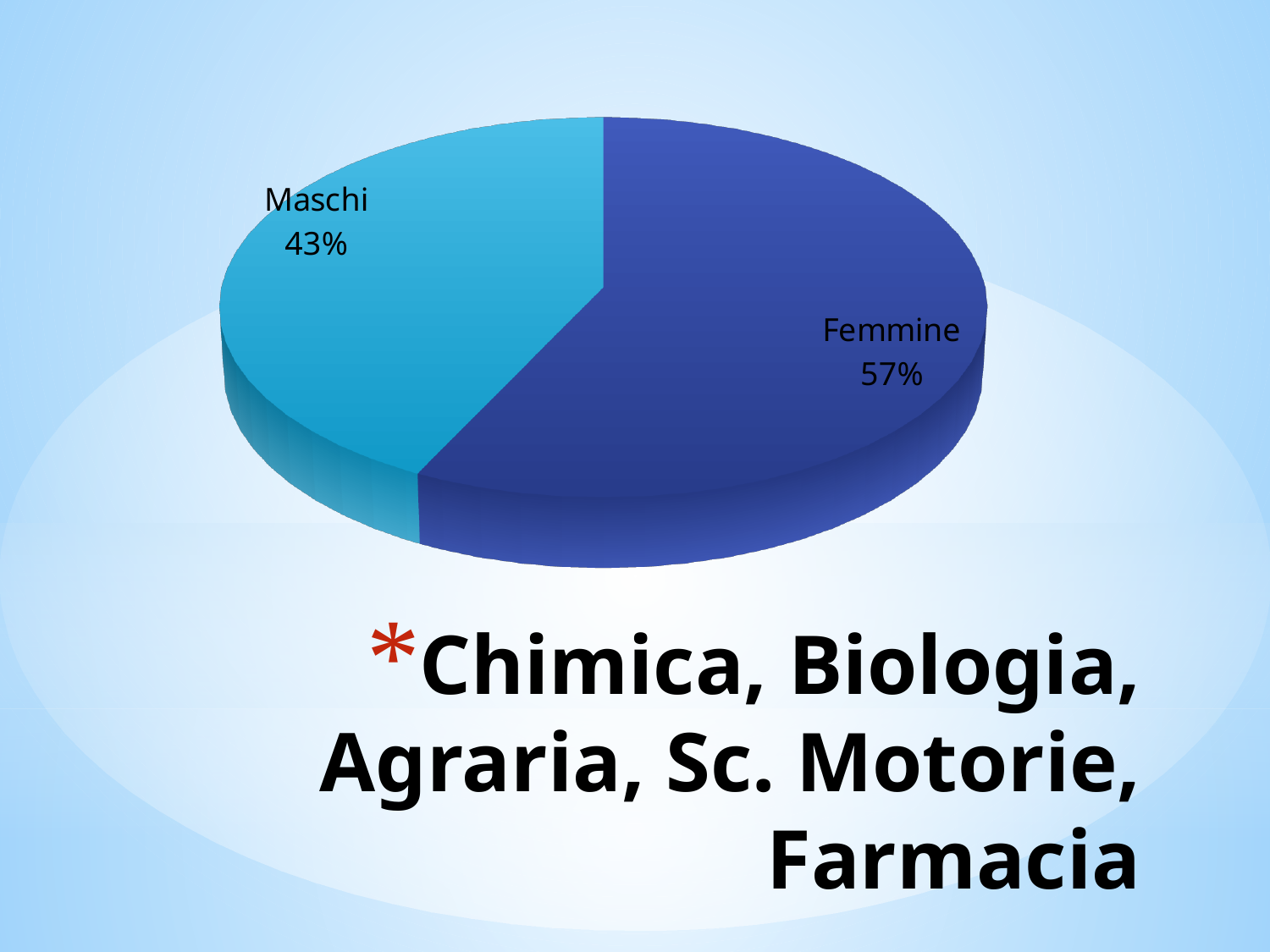
What percentage of the pie chart is Maschi? 43% Which slice of the pie chart is the smallest? Maschi What colour is the Femmine slice of the pie chart? Dark blue Which slice of the pie chart is the largest? Femmine What is the difference in percentage points between the Femmine and Maschi slices? 14 How many slices does the pie chart have? 2 Which is larger, the Maschi slice or the Femmine slice? Femmine What kind of chart is shown on the slide? Pie chart What colour is the Maschi slice of the pie chart? Light blue What percentage of the pie chart is Femmine? 57% What share of the pie does the Maschi slice represent? 43%